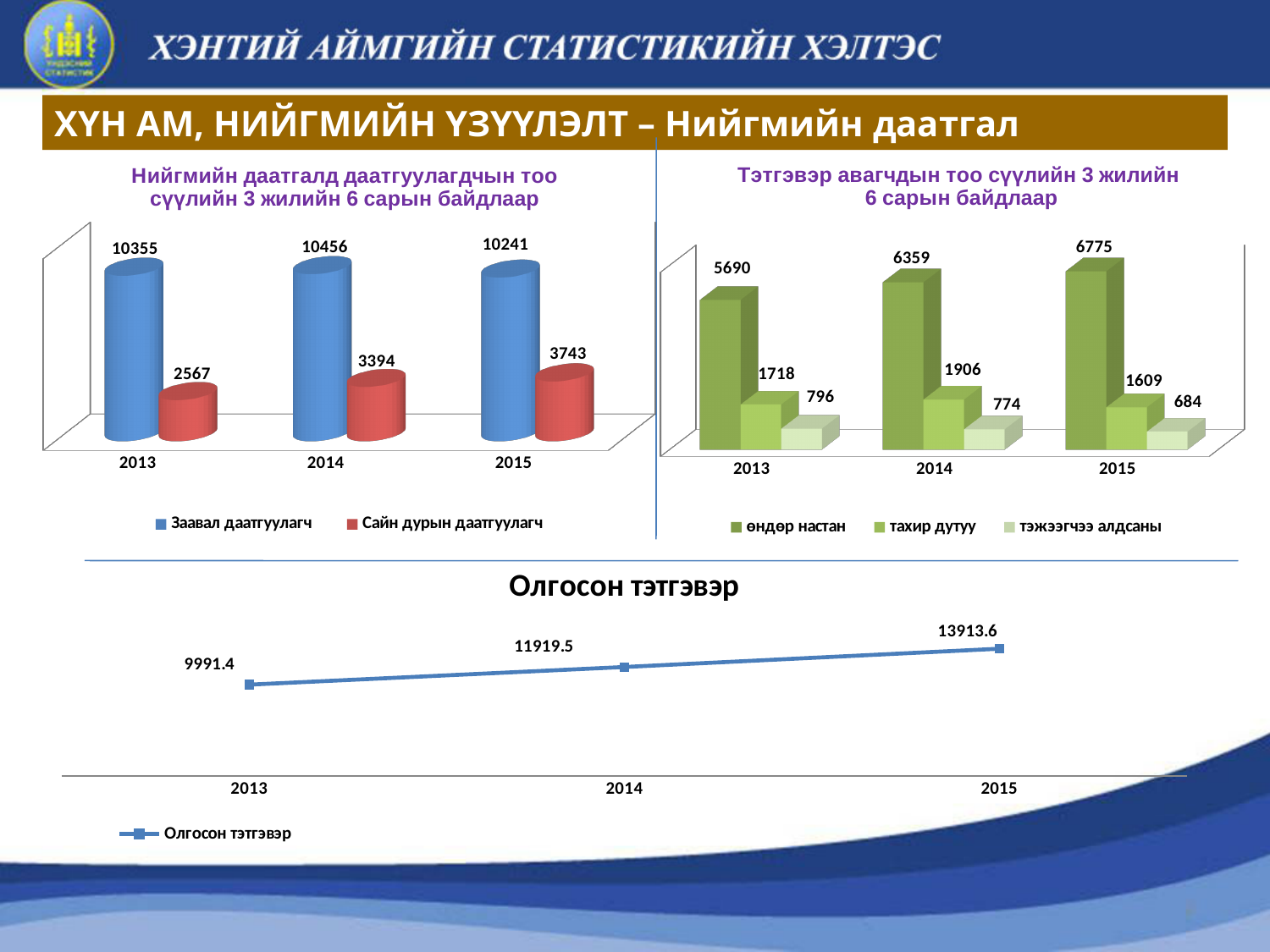
In the top-left chart (Нийгмийн даатгалд даатгуулагдчын тоо), what is the difference between the Заавал даатгуулагч and Сайн дурын даатгуулагч values in 2013? 7788 What kind of chart is the bottom chart (Олгосон тэтгэвэр)? line chart In the top-right chart (Тэтгэвэр авагчдын тоо), in which year is the тахир дутуу value lowest? 2015 In the top-right chart (Тэтгэвэр авагчдын тоо), what is the value for тэжээгчээ алдсаны in 2014? 774 In the top-left chart (Нийгмийн даатгалд даатгуулагдчын тоо), what is the value for Сайн дурын даатгуулагч in 2015? 3743 In the top-left chart (Нийгмийн даатгалд даатгуулагдчын тоо), in which year is the Заавал даатгуулагч value highest? 2014 In the top-right chart (Тэтгэвэр авагчдын тоо), how many series does the legend list? 3 In the bottom chart (Олгосон тэтгэвэр), what is the value for 2014? 11919.5 In the top-left chart (Нийгмийн даатгалд даатгуулагдчын тоо), what is the value for Заавал даатгуулагч in 2014? 10456 In the top-right chart (Тэтгэвэр авагчдын тоо), does the өндөр настан value rise or fall from 2013 to 2015? rise In the top-left chart (Нийгмийн даатгалд даатгуулагдчын тоо), how many series does the legend list? 2 In the top-right chart (Тэтгэвэр авагчдын тоо), what is the value for өндөр настан in 2015? 6775